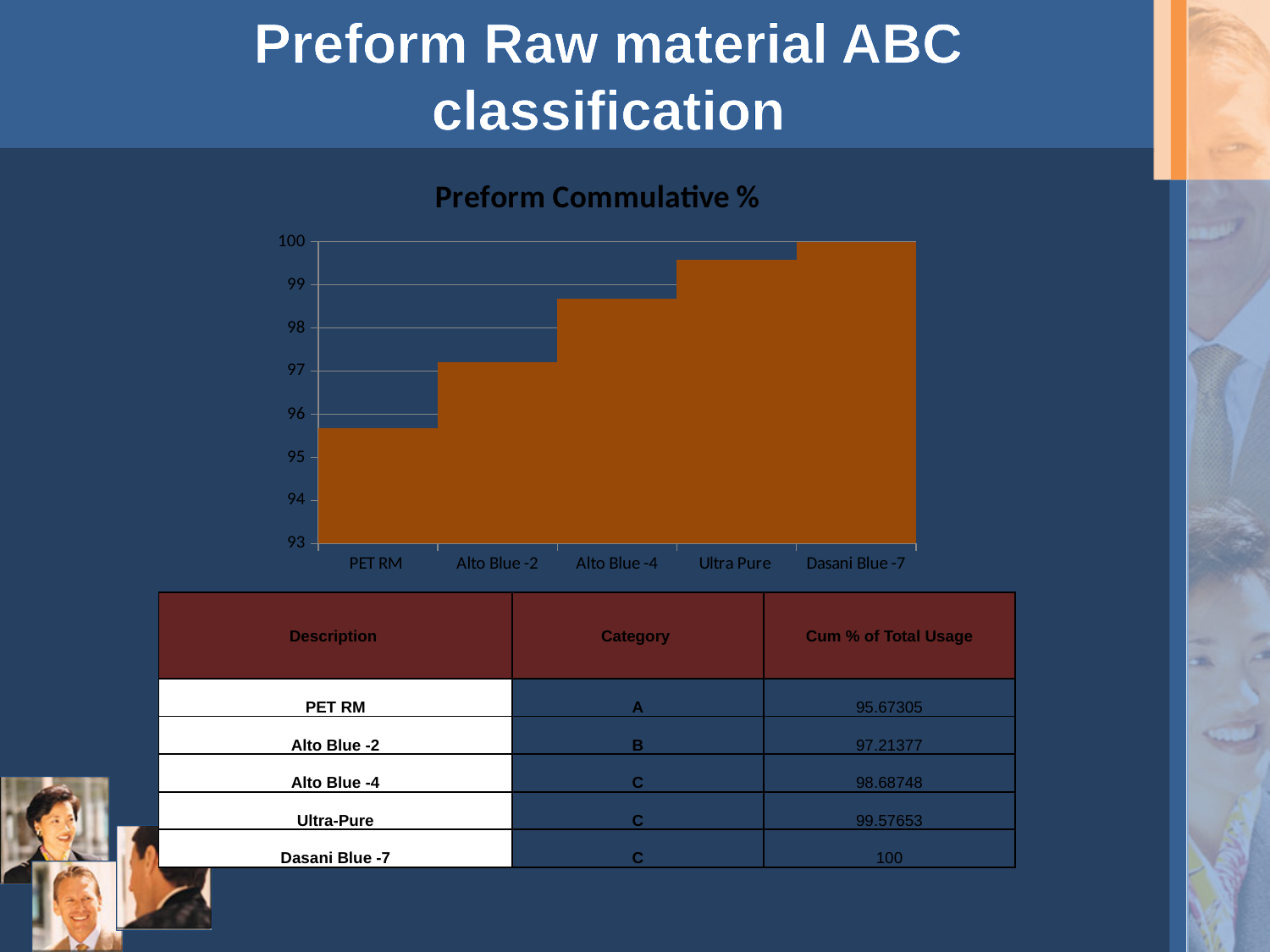
Do the values rise or fall from left to right along the x axis? rise Is the value for Alto Blue -2 greater or less than 97? greater What is the title of the chart? Preform Commulative % Is the value for PET RM greater or less than 96? less What is the label of the first category on the x axis? PET RM What kind of chart is shown on the slide? bar chart How many categories are plotted on the x axis of the chart? 5 Which category has the highest value in the chart? Dasani Blue -7 Which category has the lowest value in the chart? PET RM What is the value for Dasani Blue -7 in the chart? 100 Which is larger, the value for Ultra Pure or the value for Alto Blue -2? Ultra Pure Is the value for Alto Blue -4 greater or less than 99? less